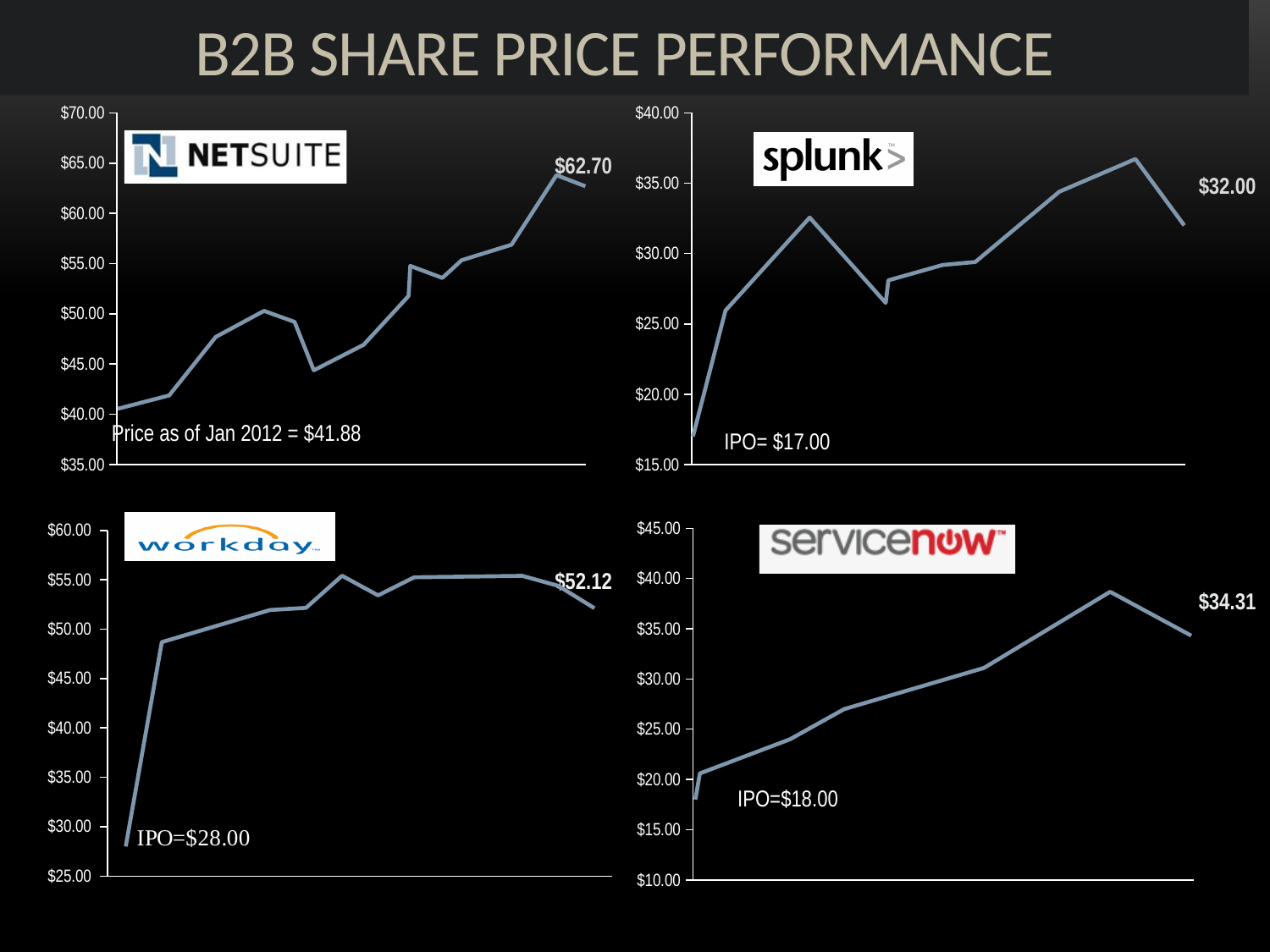
On the NetSuite chart, what is the final share price labelled at the end of the line? $62.70 Which company's chart shows the highest final labelled share price: NetSuite, Splunk, Workday or ServiceNow? NetSuite On the Splunk chart, what IPO price is stated? $17.00 On the Workday chart, what IPO price is stated? $28.00 Is the final labelled price on the Workday chart larger or smaller than the final labelled price on the ServiceNow chart? larger On the ServiceNow chart, what is the difference between the final labelled price of $34.31 and the IPO price of $18.00? $16.31 On the Workday chart, what is the final share price labelled at the end of the line? $52.12 What kind of chart is used for each of the four companies on the slide? line chart On the Splunk chart, what is the final share price labelled at the end of the line? $32.00 On the ServiceNow chart, is the peak value of the line greater or less than $35.00? greater On the ServiceNow chart, what is the final share price labelled at the end of the line? $34.31 On the Splunk chart, what is the difference between the final labelled price and the IPO price? $15.00